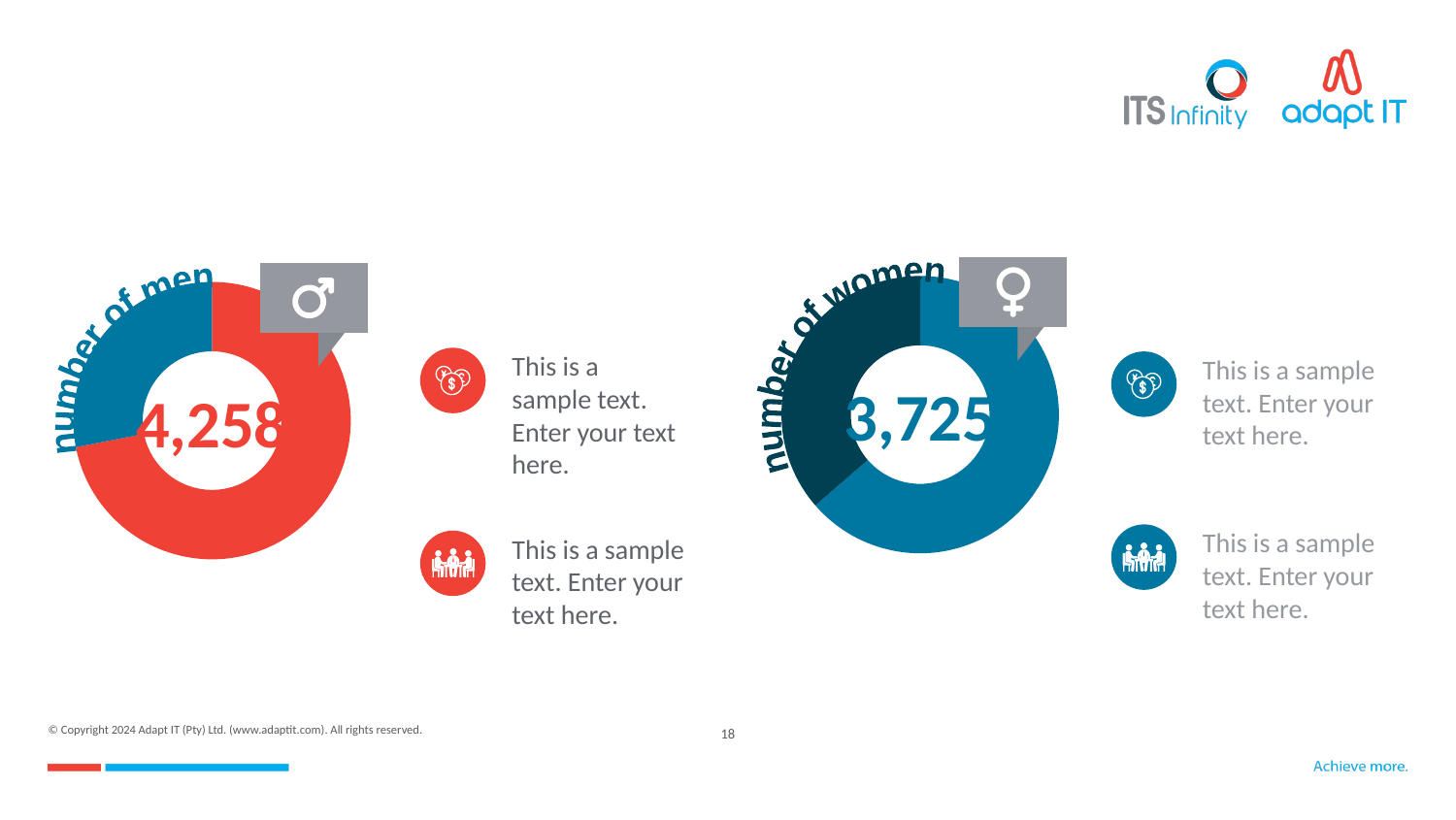
What colour is the larger slice of the 'number of men' donut chart? red On the 'number of women' chart, what number is printed in the centre of the donut? 3,725 On the 'number of men' chart, what number is printed in the centre of the donut? 4,258 Which is larger, the number of men (4,258) or the number of women (3,725)? number of men What is the difference between the number of men (4,258) and the number of women (3,725)? 533 How many donut charts are shown on the slide? 2 What is the title of the left-hand donut chart? number of men What kind of chart is used for 'number of women'? donut (pie) chart What kind of chart is used for 'number of men'? donut (pie) chart How many slices does the 'number of women' donut chart have? 2 How many slices does the 'number of men' donut chart have? 2